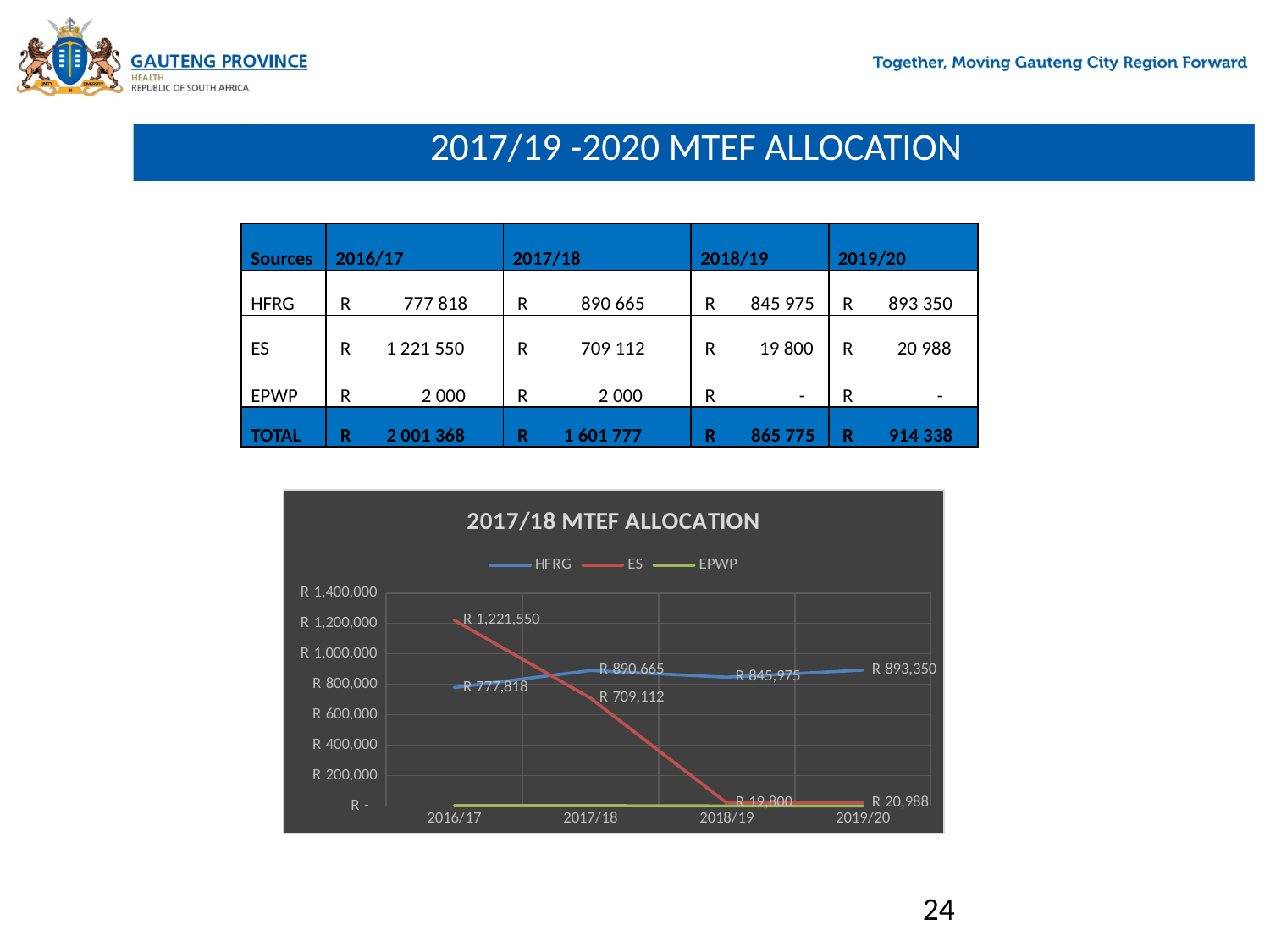
Which is larger in 2017/18 on the chart, HFRG or ES? HFRG How many series does the chart legend list? 3 What type of chart is shown on the slide? Line chart In which year is the ES value highest on the chart? 2016/17 What is the value for HFRG in 2019/20 on the chart? R 893,350 What is the difference between the ES values for 2016/17 and 2017/18 on the chart? R 512,438 In which year is the HFRG value lowest on the chart? 2016/17 How many years are shown on the x axis of the chart? 4 What is the title of the chart? 2017/18 MTEF ALLOCATION What is the value for ES in 2018/19 on the chart? R 19,800 What is the value for HFRG in 2016/17 on the chart? R 777,818 What is the value for ES in 2017/18 on the chart? R 709,112